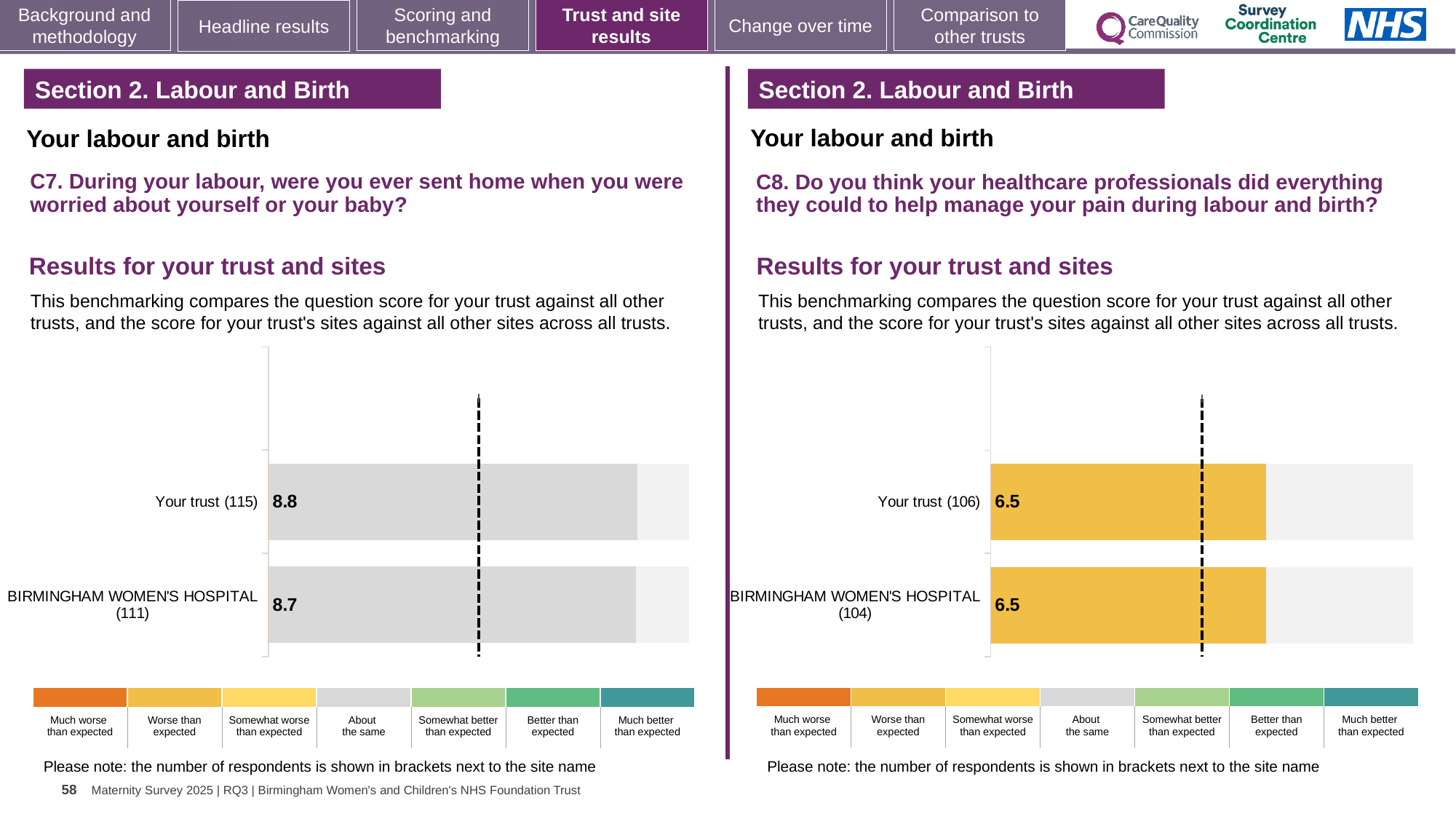
On the C8 chart, what is the score for Your trust? 6.5 On the C7 chart, what is the score for Your trust? 8.8 On the C8 chart, how many respondents are shown in brackets for Birmingham Women's Hospital? 104 On the C7 chart, which has the higher score, Your trust or Birmingham Women's Hospital? Your trust On the C7 chart, which benchmark category does the colour of the bars correspond to in the legend? About the same On the C7 chart, what is the score for Birmingham Women's Hospital? 8.7 On the C7 chart, what is the difference between the Your trust score and the Birmingham Women's Hospital score? 0.1 On the C8 chart, how many bars are plotted? 2 What type of chart is used on the C7 chart? Bar chart On the C7 chart, how many respondents are shown in brackets for Your trust? 115 On the C8 chart, which benchmark category does the colour of the bars correspond to in the legend? Worse than expected On the C8 chart, what is the score for Birmingham Women's Hospital? 6.5